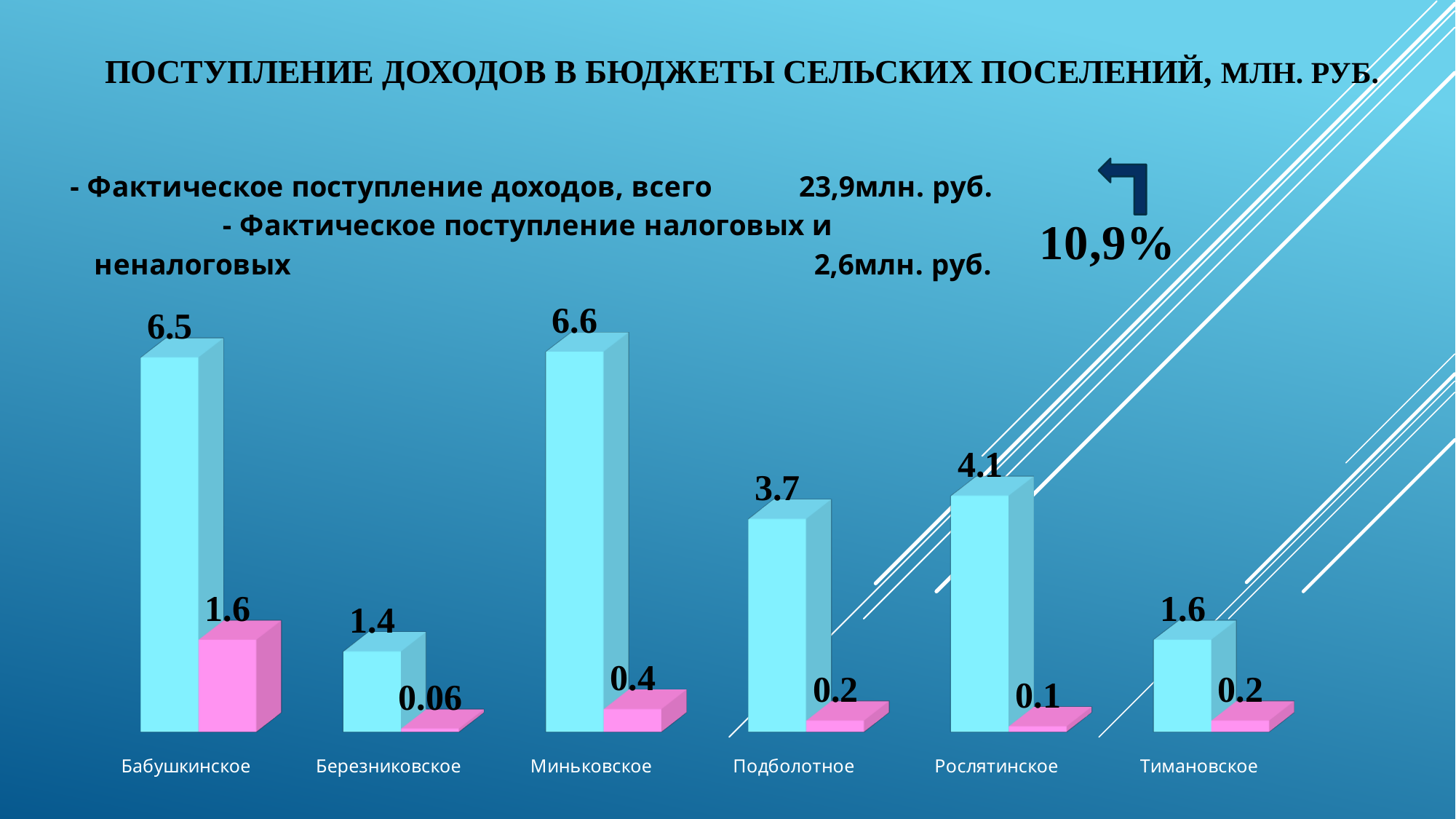
Which category has the highest pink bar? Бабушкинское What is the difference between the light blue bars for Рослятинское and Подболотное? 0.4 What is the value of the light blue bar for Миньковское? 6.6 Which category has the lowest light blue bar? Березниковское What is the value of the pink bar for Бабушкинское? 1.6 What is the value of the pink bar for Березниковское? 0.06 Which is larger: the light blue bar for Бабушкинское or the light blue bar for Подболотное? Бабушкинское How many categories are shown on the x axis? 6 What kind of chart is shown on the slide? Bar chart What is the difference between the light blue and pink bars for Миньковское? 6.2 Which category has the highest light blue bar? Миньковское What is the value of the light blue bar for Рослятинское? 4.1